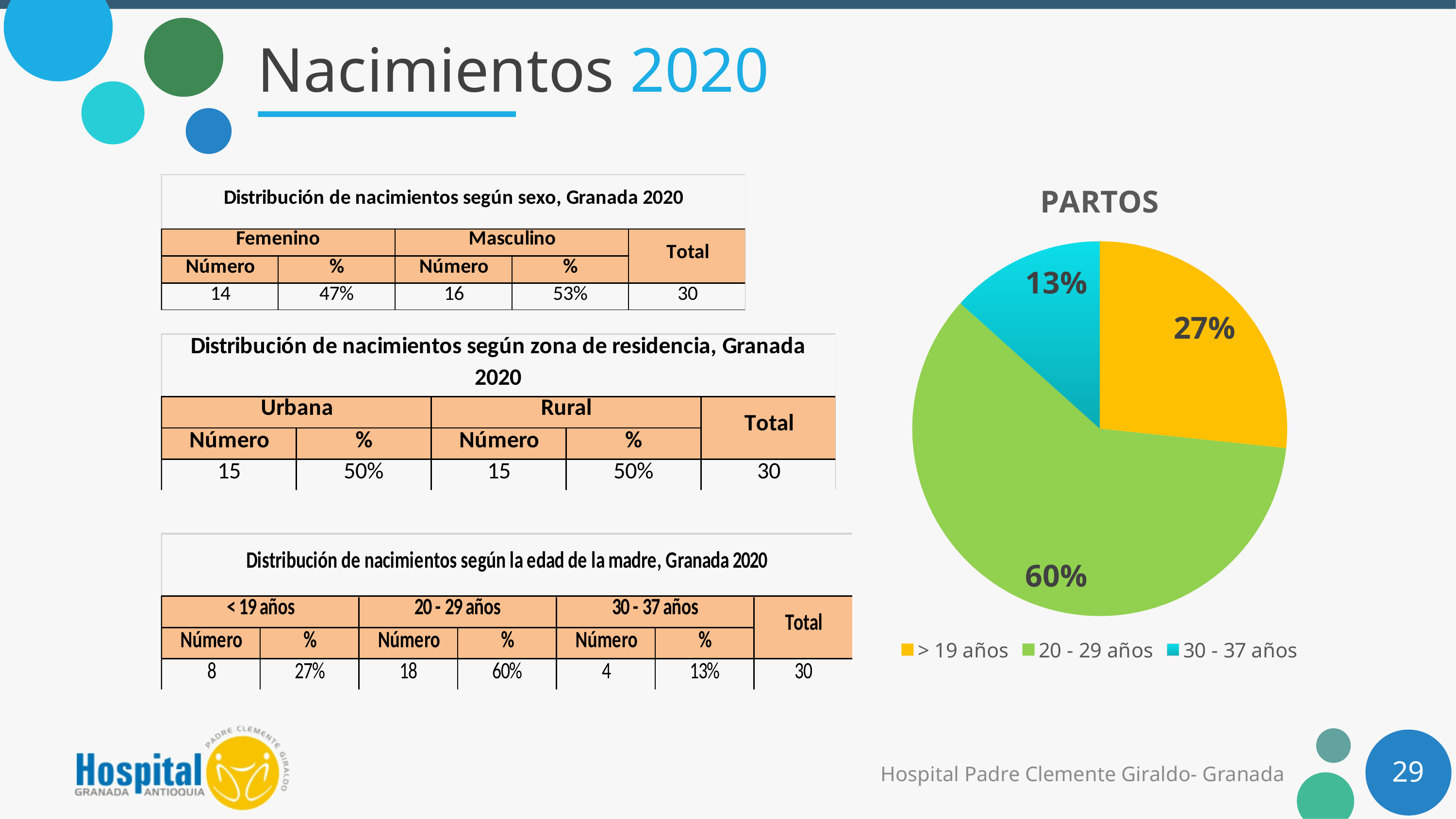
In the PARTOS pie chart, which slice is larger: > 19 años or 30 - 37 años? > 19 años What kind of chart is the PARTOS chart? pie chart In the PARTOS pie chart, what share is shown for the > 19 años slice? 27% In the PARTOS pie chart, what is the difference in percentage points between the 20 - 29 años slice and the > 19 años slice? 33% In the PARTOS pie chart, what share is shown for the 20 - 29 años slice? 60% How many entries does the legend of the PARTOS pie chart list? 3 In the PARTOS pie chart, what share is shown for the 30 - 37 años slice? 13% In the PARTOS pie chart, what is the difference in percentage points between the > 19 años slice and the 30 - 37 años slice? 14% How many slices does the PARTOS pie chart have? 3 What is the title of the pie chart on the slide? PARTOS In the PARTOS pie chart, which age group has the largest slice? 20 - 29 años In the PARTOS pie chart, which age group has the smallest slice? 30 - 37 años